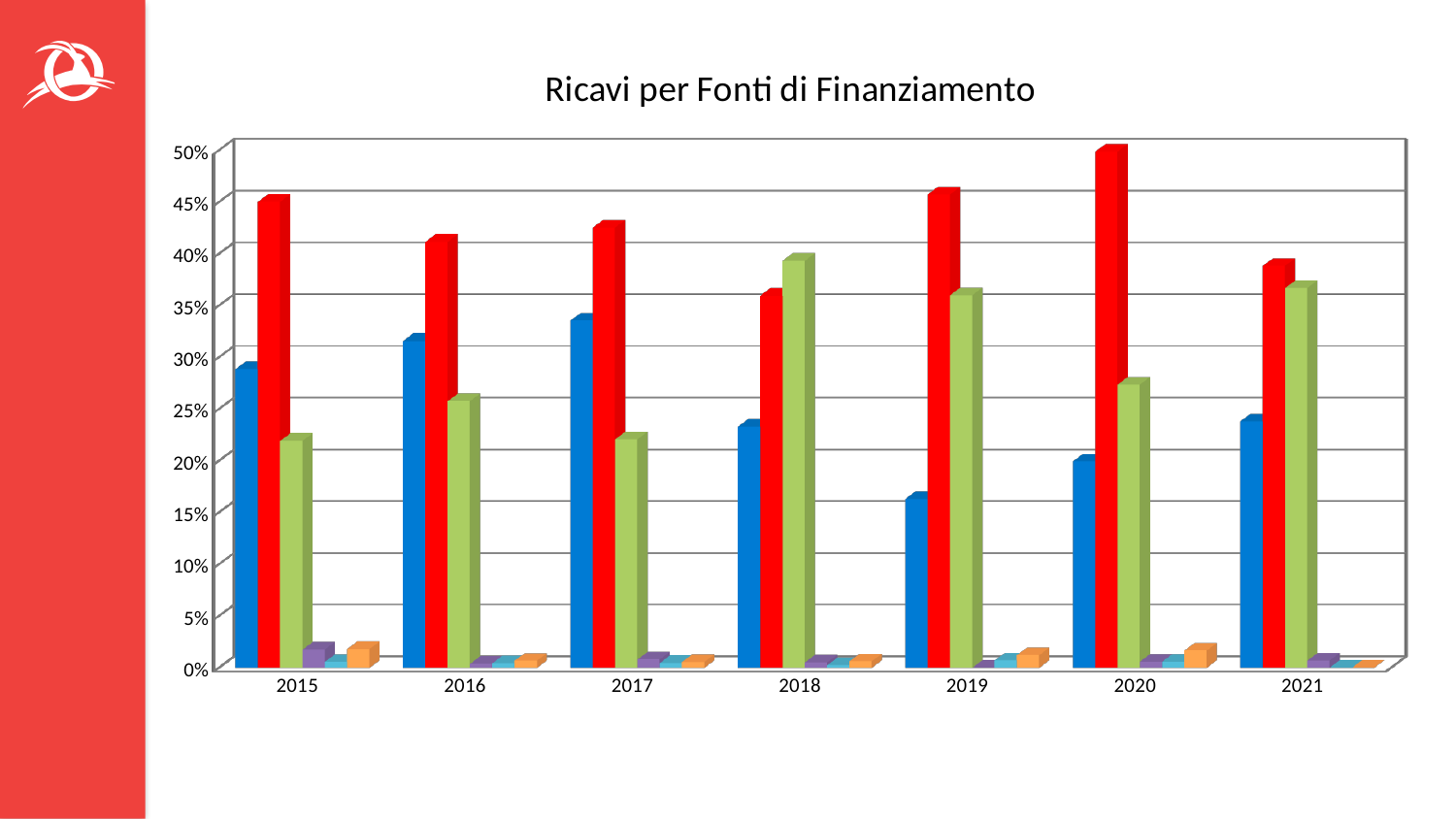
In which year is the blue bar the lowest? 2019 Does the blue bar rise or fall from 2015 to 2017? rises How many bars are plotted for each year in the chart? 6 How many years are shown on the x axis of the chart? 7 For 2018, which is larger: the red bar or the green bar? the green bar In which year is the green bar the highest? 2018 Is the value of the red bar for 2020 greater or less than 45%? greater What is the title of the chart? Ricavi per Fonti di Finanziamento In which year is the red bar the highest? 2020 What kind of chart is shown on the slide? bar chart Is the value of the blue bar for 2019 greater or less than 20%? less Is the value of the green bar for 2016 greater or less than 20%? greater